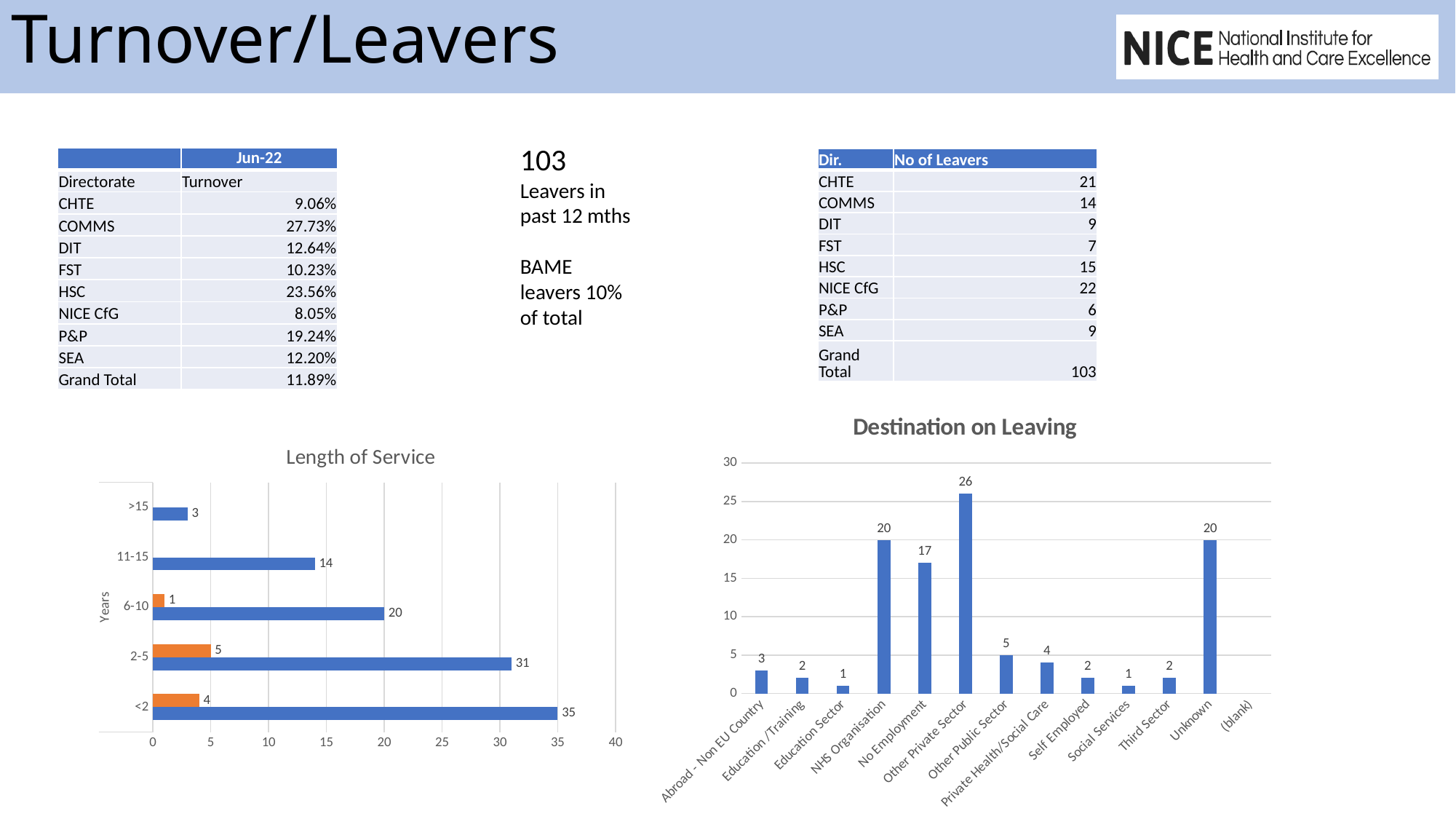
In the Destination on Leaving chart, which destination has the highest value? Other Private Sector In the Length of Service chart, what is the value of the orange bar for the 2-5 category? 5 What kind of chart is the Destination on Leaving chart? Bar chart In the Destination on Leaving chart, what is the value for Other Private Sector? 26 In the Length of Service chart, which category has the lowest blue bar value? >15 In the Destination on Leaving chart, what is the value for No Employment? 17 In the Destination on Leaving chart, what is the difference between NHS Organisation and No Employment? 3 In the Destination on Leaving chart, which is larger: Other Public Sector or Private Health/Social Care? Other Public Sector In the Length of Service chart, what is the value of the blue bar for the <2 category? 35 In the Length of Service chart, what is the difference between the blue bars for <2 and 2-5? 4 In the Destination on Leaving chart, what is the value for Unknown? 20 What is the label on the vertical axis of the Length of Service chart? Years